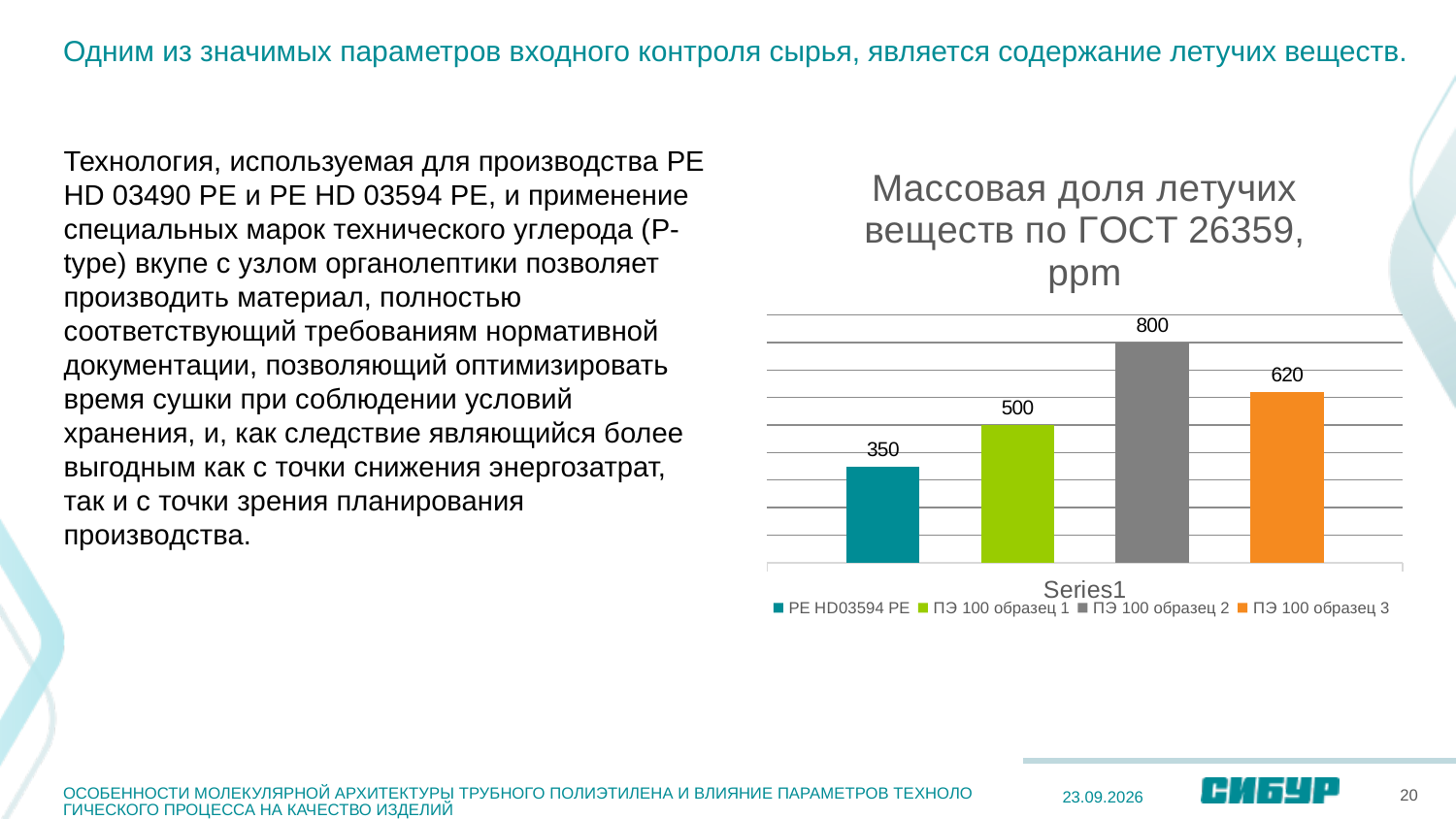
What is the value for ПЭ 100 образец 2? 800 What is the difference between the values for ПЭ 100 образец 2 and PE HD03594 PE? 450 What is the title of the chart? Массовая доля летучих веществ по ГОСТ 26359, ppm What is the value for ПЭ 100 образец 1? 500 Which series has the highest value in the chart? ПЭ 100 образец 2 Which is larger, the value for ПЭ 100 образец 1 or the value for ПЭ 100 образец 3? ПЭ 100 образец 3 What is the value for PE HD03594 PE in the chart? 350 What is the value for ПЭ 100 образец 3? 620 Which series has the lowest value in the chart? PE HD03594 PE What kind of chart is shown on the slide? Bar chart What is the difference between the values for ПЭ 100 образец 3 and ПЭ 100 образец 1? 120 How many series does the legend list? 4